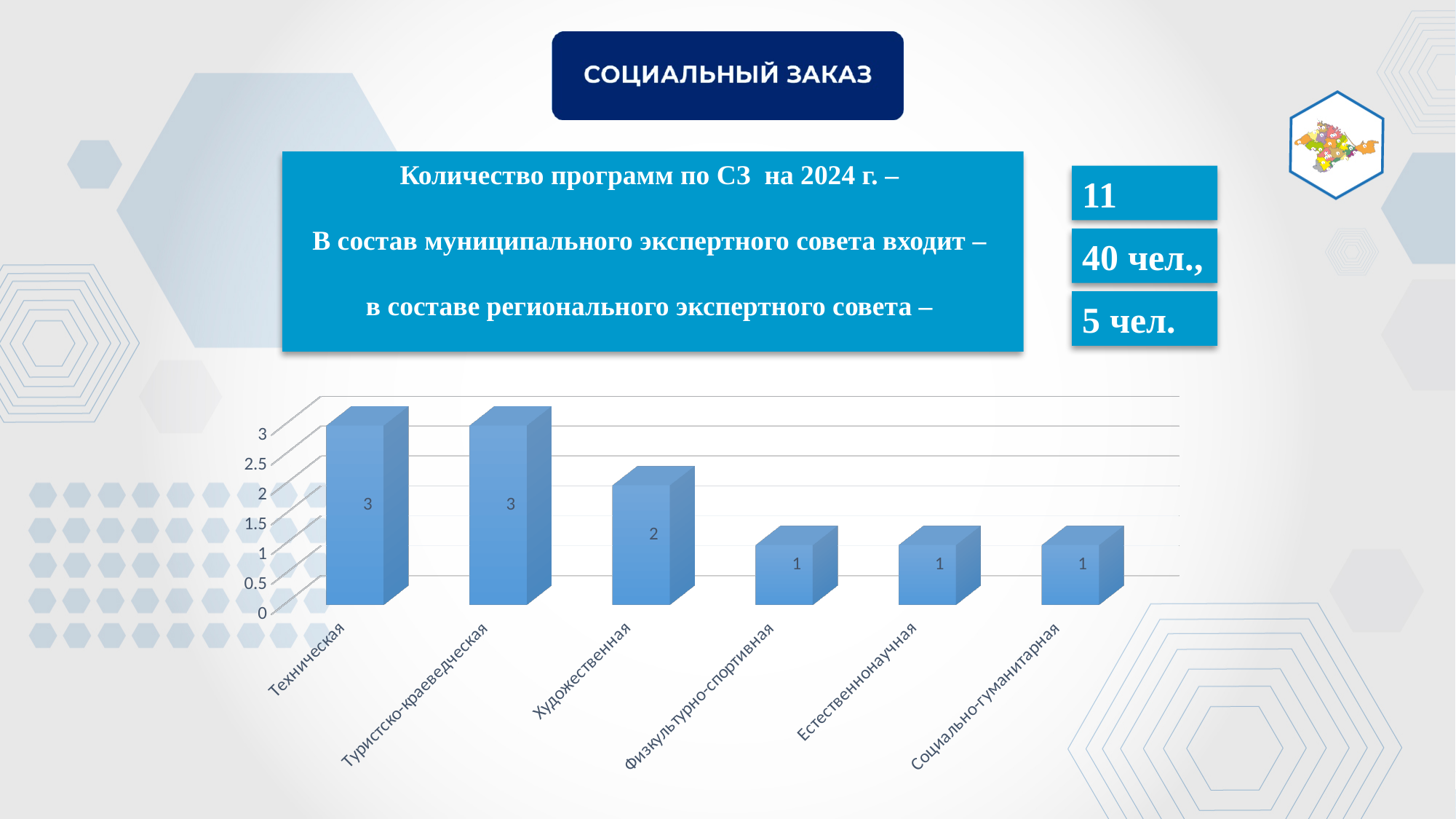
What is the difference between the values for Туристско-краеведческая and Естественнонаучная? 2 Do the values rise or fall from left to right along the x axis? fall How many categories are shown on the x axis of the chart? 6 Which is larger, the value for Художественная or the value for Естественнонаучная? Художественная What is the difference between the values for Художественная and Физкультурно-спортивная? 1 What kind of chart is shown on the slide? bar chart What is the value for Социально-гуманитарная? 1 Is the value for Туристско-краеведческая greater or less than 2? greater What is the value for Физкультурно-спортивная? 1 Which category has the lowest value among Техническая, Туристско-краеведческая and Художественная? Художественная What is the value for Техническая? 3 What is the value for Художественная? 2